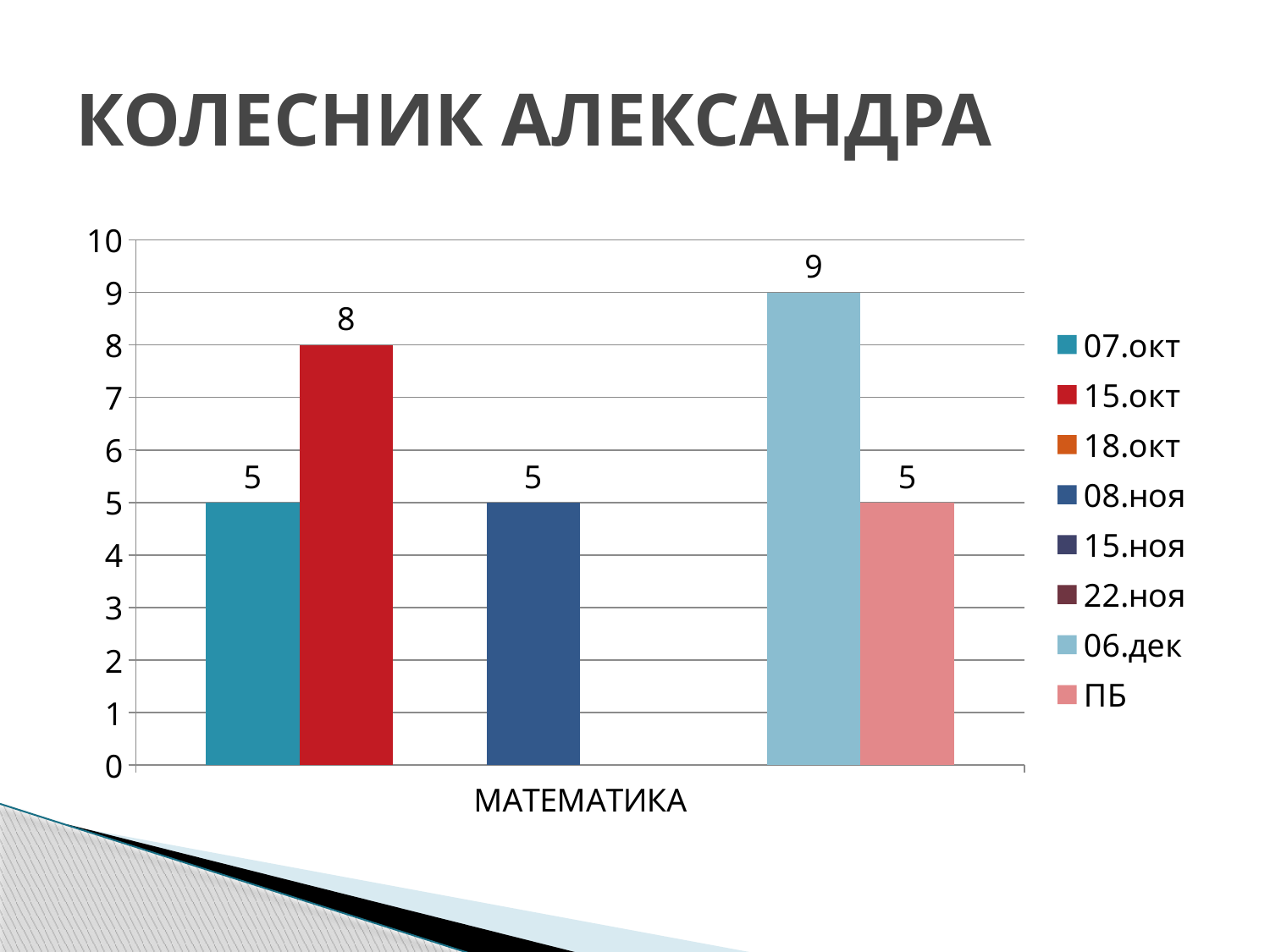
What is the difference between the values for 15.окт and 08.ноя? 3 What is the title of the slide? КОЛЕСНИК АЛЕКСАНДРА Which series has the highest value in the МАТЕМАТИКА category? 06.дек How many series does the legend list? 8 What is the value for ПБ in the МАТЕМАТИКА category? 5 What is the value for 06.дек in the МАТЕМАТИКА category? 9 What kind of chart is shown on the slide? Bar chart What is the value for 15.окт in the МАТЕМАТИКА category? 8 Which is larger, the value for 15.окт or the value for 07.окт? 15.окт What is the value for 07.окт in the МАТЕМАТИКА category? 5 How many categories are shown on the x axis? 1 What is the difference between the values for 06.дек and 15.окт? 1